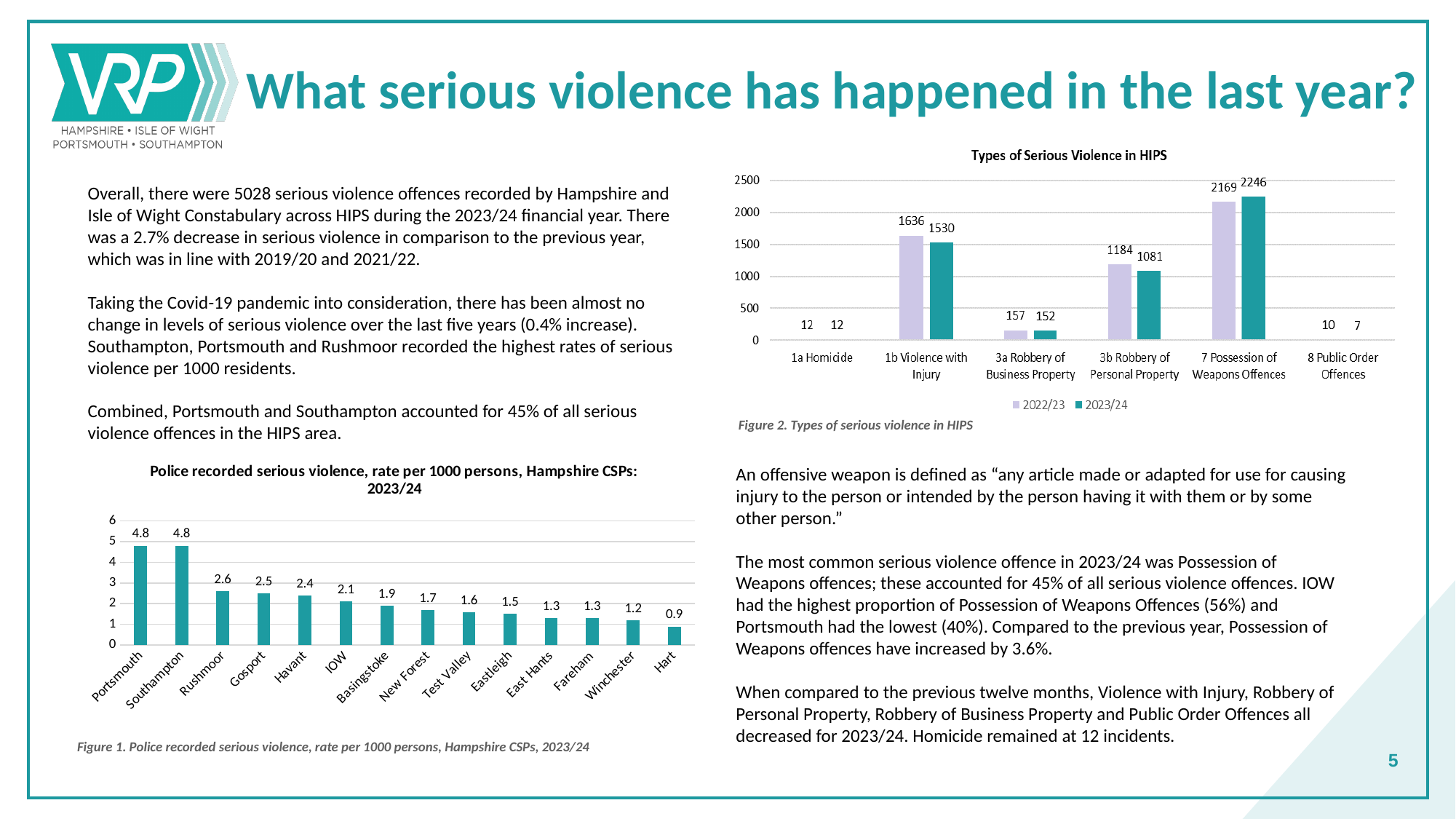
In the 'Police recorded serious violence, rate per 1000 persons, Hampshire CSPs: 2023/24' chart, how many CSPs are shown? 14 In the 'Police recorded serious violence, rate per 1000 persons, Hampshire CSPs: 2023/24' chart, which CSP has the lowest rate? Hart In the 'Types of Serious Violence in HIPS' chart, how many series does the legend list? 2 In the 'Types of Serious Violence in HIPS' chart, what is the 2023/24 value for 1b Violence with Injury? 1530 In the 'Police recorded serious violence, rate per 1000 persons, Hampshire CSPs: 2023/24' chart, what is the difference between the values for Gosport and Havant? 0.1 In the 'Types of Serious Violence in HIPS' chart, what is the difference between the 2022/23 and 2023/24 values for 7 Possession of Weapons Offences? 77 In the 'Police recorded serious violence, rate per 1000 persons, Hampshire CSPs: 2023/24' chart, what is the value for Rushmoor? 2.6 In the 'Types of Serious Violence in HIPS' chart, which category has the highest 2023/24 value? 7 Possession of Weapons Offences In the 'Types of Serious Violence in HIPS' chart, which is larger for 3a Robbery of Business Property: the 2022/23 value or the 2023/24 value? 2022/23 In the 'Types of Serious Violence in HIPS' chart, what is the 2022/23 value for 3b Robbery of Personal Property? 1184 What kind of chart is the 'Types of Serious Violence in HIPS' chart? bar chart In the 'Police recorded serious violence, rate per 1000 persons, Hampshire CSPs: 2023/24' chart, do the values rise or fall from left to right? fall